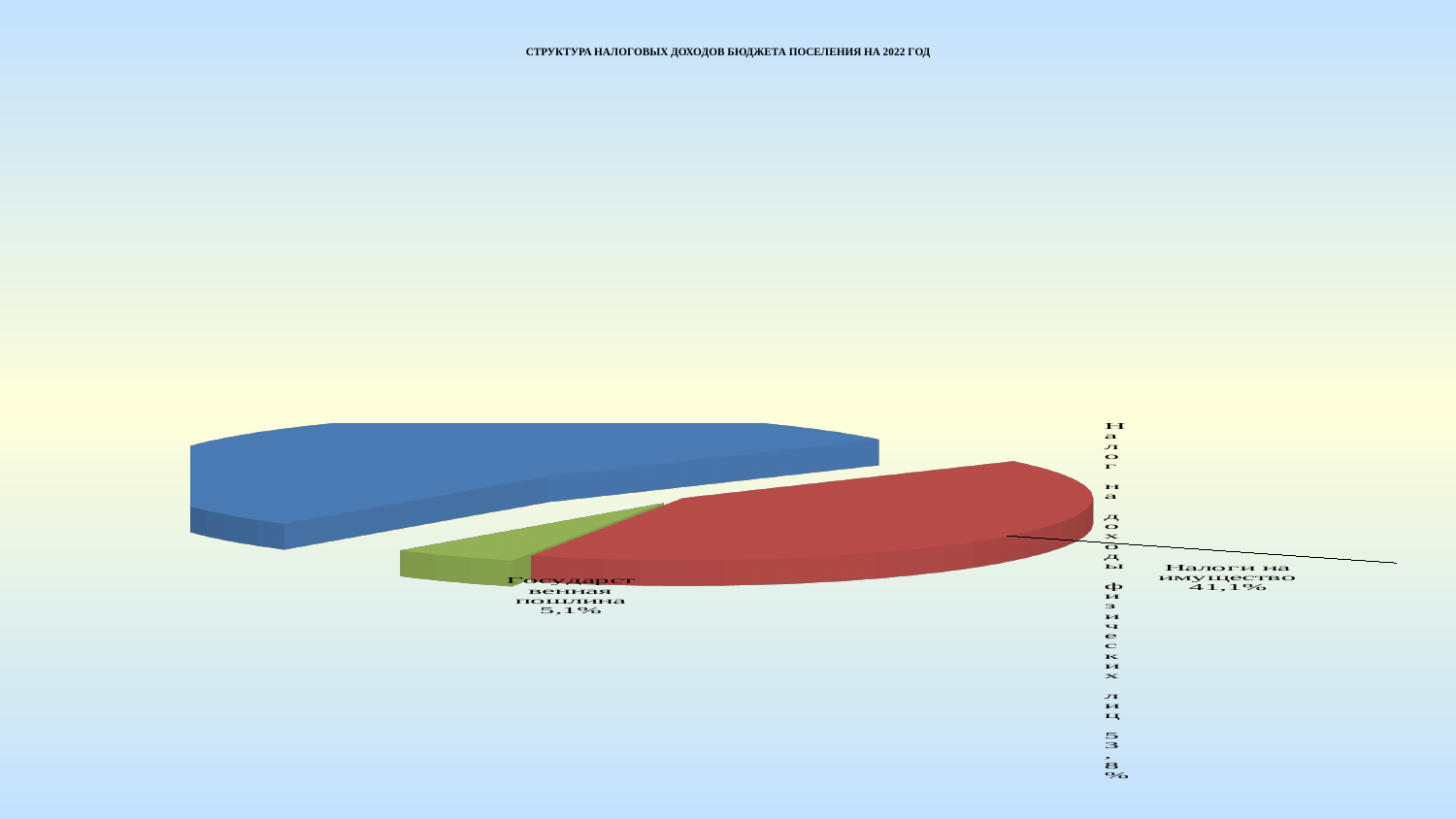
Which category has the smallest share of the pie? Государственная пошлина What is the difference in percentage points between Налог на доходы физических лиц and Налоги на имущество? 12,7 What share of the pie is Государственная пошлина? 5,1% Which category has the largest share of the pie? Налог на доходы физических лиц What is the difference in percentage points between Налоги на имущество and Государственная пошлина? 36,0 What kind of chart is shown on the slide? pie chart What share of the pie is Налоги на имущество? 41,1% How many slices does the pie chart have? 3 What share of the pie is Налог на доходы физических лиц? 53,8% Which is larger: Налоги на имущество or Государственная пошлина? Налоги на имущество What colour is the slice for Государственная пошлина? green What is the title of the chart? СТРУКТУРА НАЛОГОВЫХ ДОХОДОВ БЮДЖЕТА ПОСЕЛЕНИЯ НА 2022 ГОД